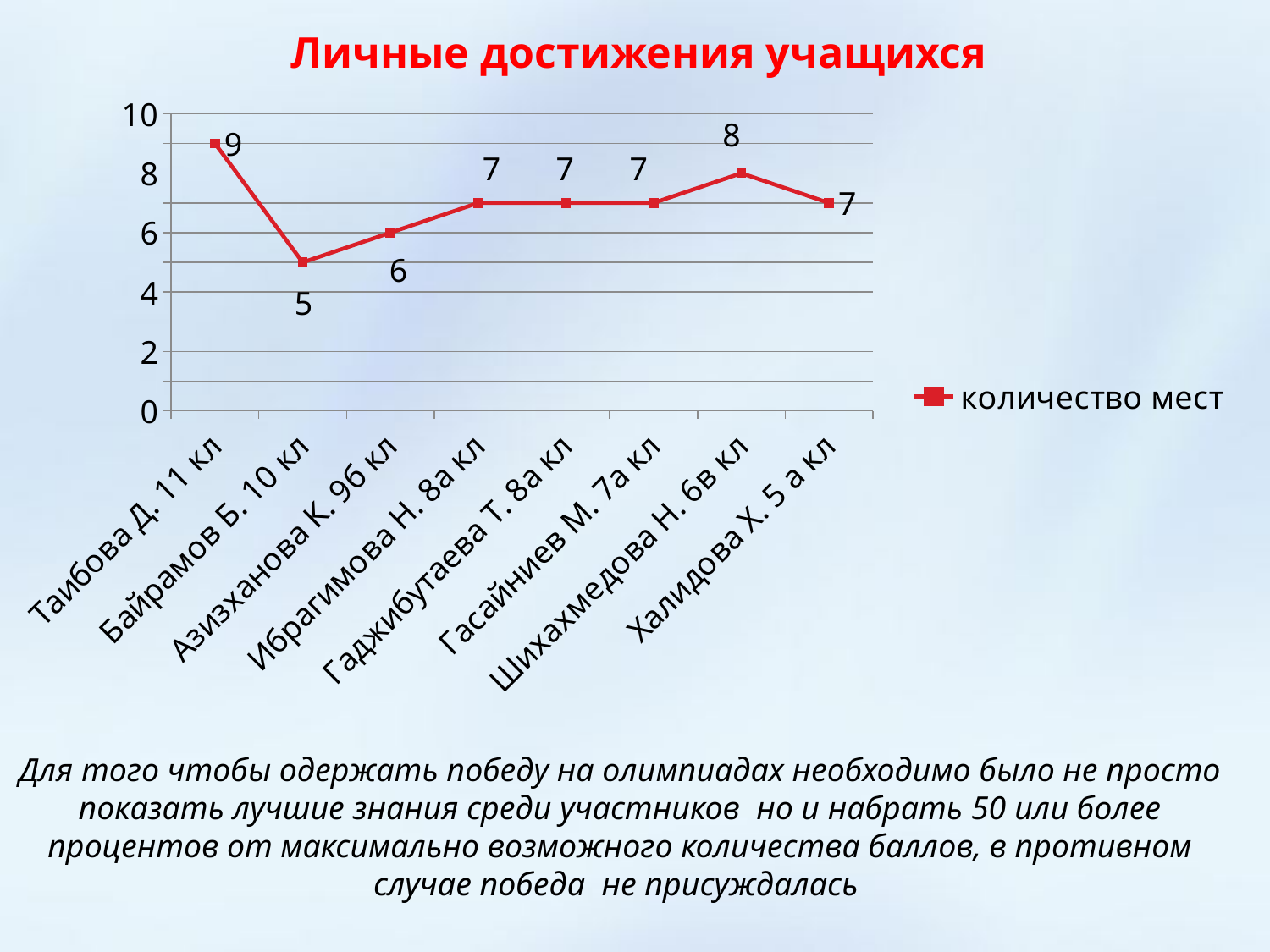
Which student has the highest value? Таибова Д. 11 кл What is the value for Шихахмедова Н. 6в кл? 8 What is the value for Азизханова К. 9б кл? 6 What is the difference between the values for Таибова Д. 11 кл and Байрамов Б. 10 кл? 4 What type of chart is shown on the slide? line chart What is the title of the chart? Личные достижения учащихся What is the value for Таибова Д. 11 кл? 9 What is the value for Байрамов Б. 10 кл? 5 Which student has the lowest value? Байрамов Б. 10 кл How many series does the legend list? 1 Which is larger, the value for Шихахмедова Н. 6в кл or the value for Халидова Х. 5 а кл? Шихахмедова Н. 6в кл How many students are plotted on the x axis? 8